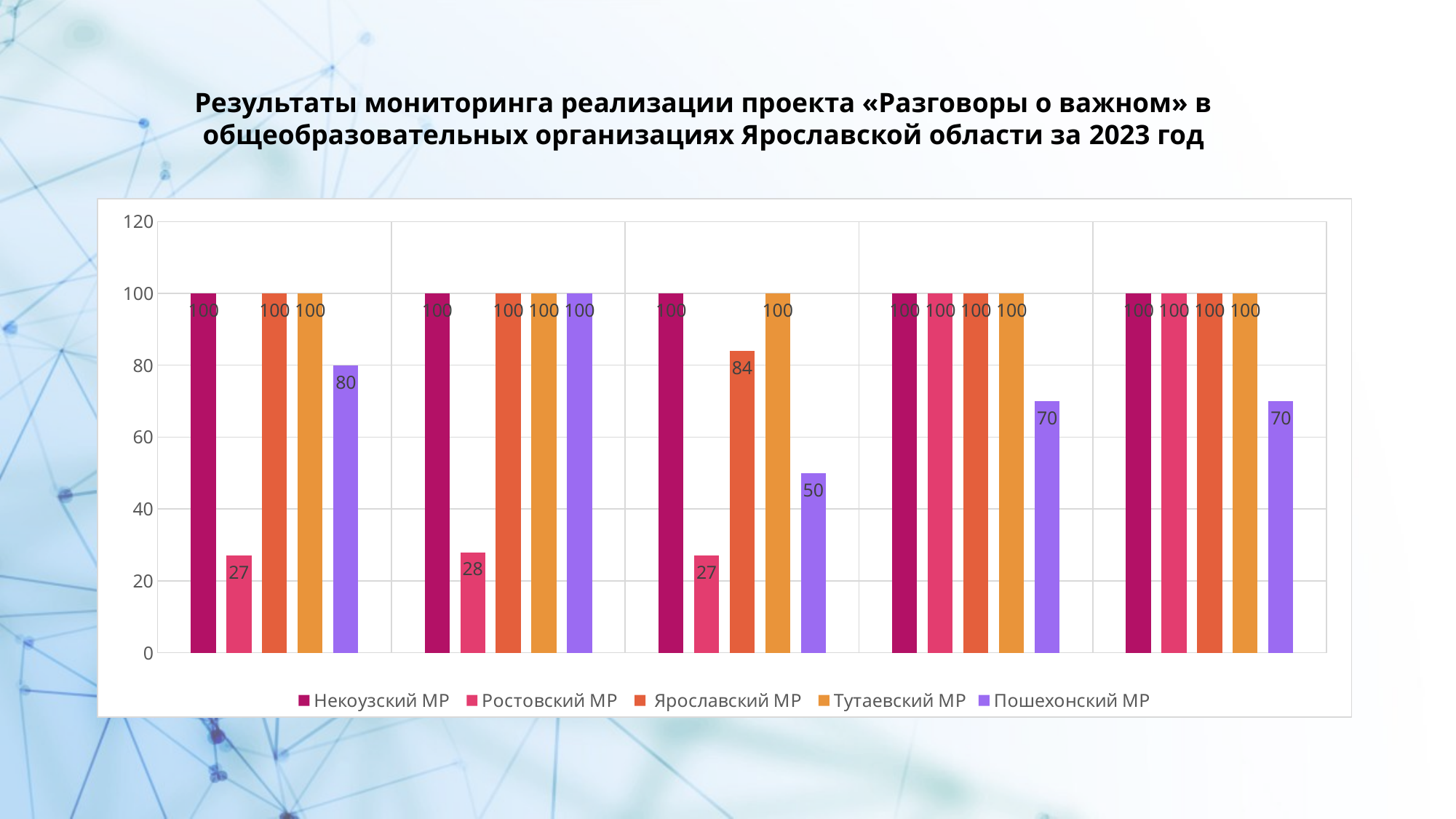
What is the value for Пошехонский МР in the third group of bars? 50 How many series does the legend list? 5 Which series is shown in purple in the legend? Пошехонский МР What is the value for Ростовский МР in the first (leftmost) group of bars? 27 How many groups of bars are plotted along the x axis? 5 What kind of chart is shown on the slide? bar chart What is the difference between Некоузский МР and Ростовский МР in the first (leftmost) group of bars? 73 What is the value for Ярославский МР in the third group of bars? 84 Which series has the lowest value in the second group of bars? Ростовский МР In the third group of bars, which is larger: Ярославский МР or Пошехонский МР? Ярославский МР What is the difference between Тутаевский МР and Пошехонский МР in the fourth group of bars? 30 What is the value for Пошехонский МР in the first (leftmost) group of bars? 80